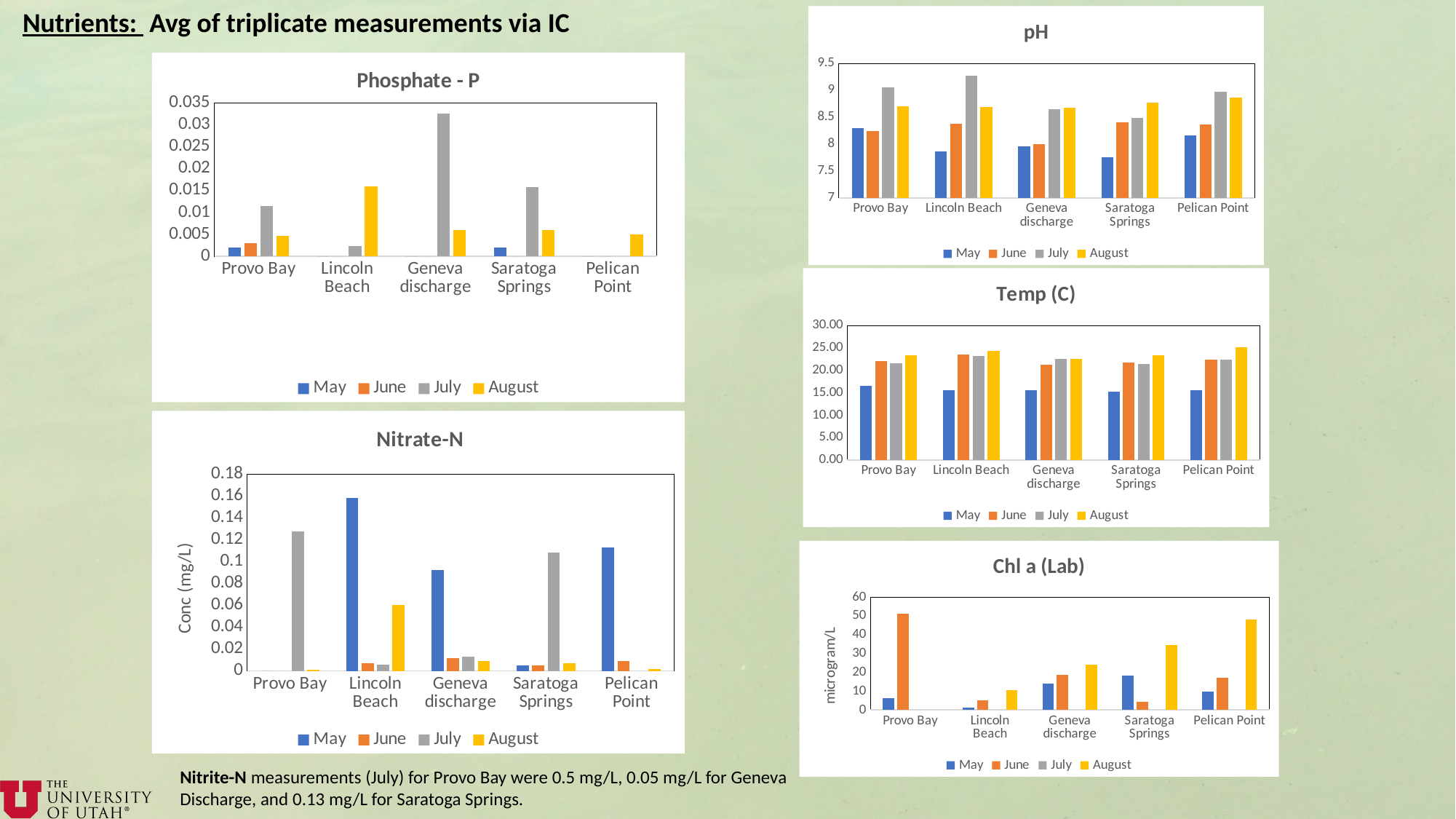
In the Temp (C) chart, is the August value for Pelican Point greater or less than 20.00? greater In the Nitrate-N chart, is the May value for Lincoln Beach greater or less than 0.14? greater In the Nitrate-N chart, which site has the highest May value? Lincoln Beach In the Chl a (Lab) chart, which site has the highest June value? Provo Bay In the Phosphate - P chart, is the July value for Geneva discharge greater or less than 0.025? greater In the Nitrate-N chart, which is larger: the May value for Lincoln Beach or the May value for Pelican Point? Lincoln Beach In the Phosphate - P chart, which site and month has the highest value? Geneva discharge, July How many series does the legend of the Nitrate-N chart list? 4 How many sites are shown on the x axis of the Phosphate - P chart? 5 What is the y-axis label of the Chl a (Lab) chart? microgram/L